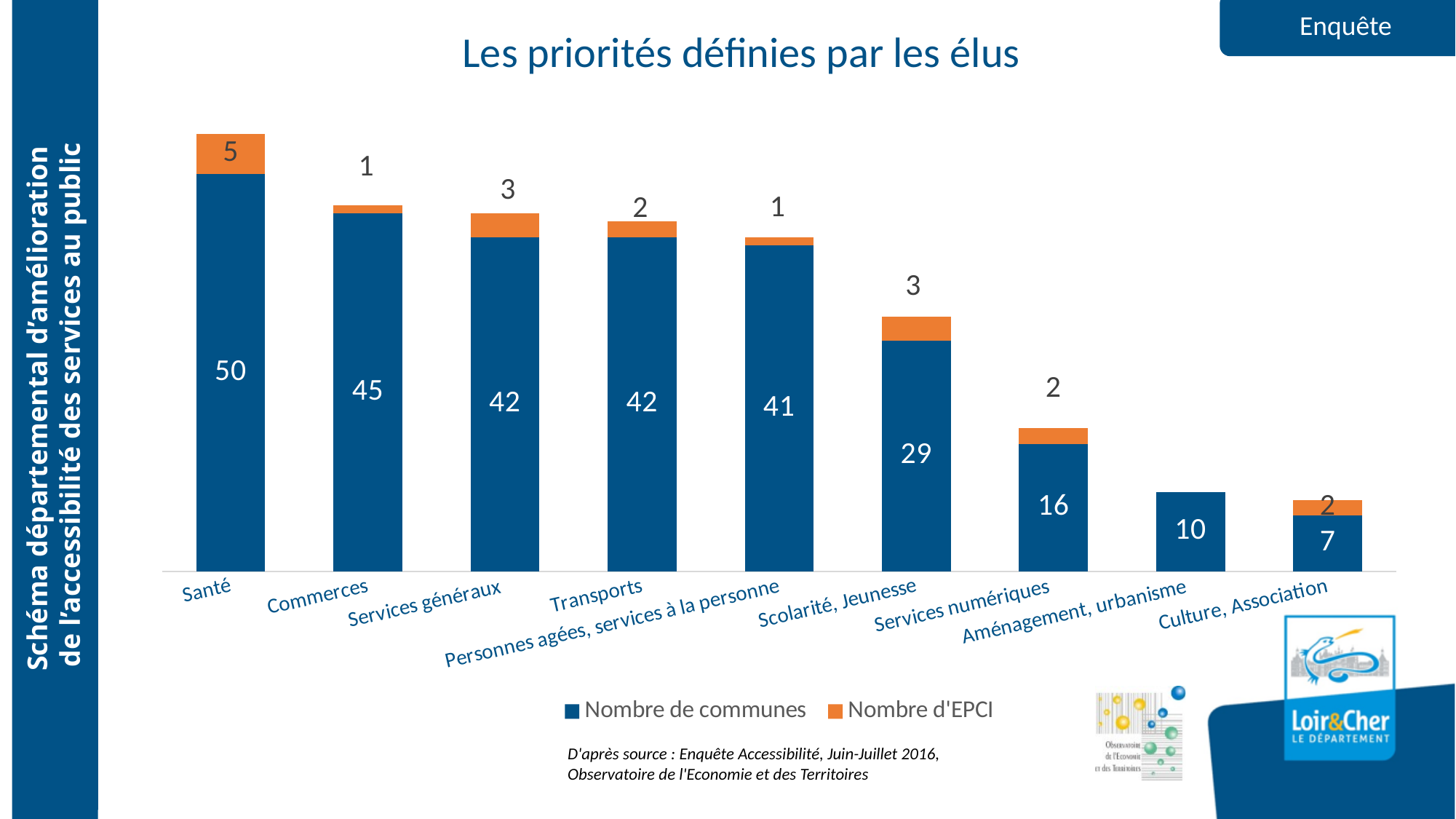
What is the value of 'Nombre d'EPCI' for Services généraux? 3 What is the title of the chart? Les priorités définies par les élus How many categories are shown on the x axis? 9 What is the total of the stacked bar for Santé? 55 Which has a larger 'Nombre de communes', Transports or Aménagement, urbanisme? Transports How many series does the legend list? 2 Which category has the lowest 'Nombre de communes'? Culture, Association Which category has the highest 'Nombre de communes'? Santé What is the value of 'Nombre de communes' for Santé? 50 What is the difference in 'Nombre de communes' between Commerces and Services numériques? 29 What type of chart is shown on the slide? Stacked bar chart What is the value of 'Nombre de communes' for Scolarité, Jeunesse? 29